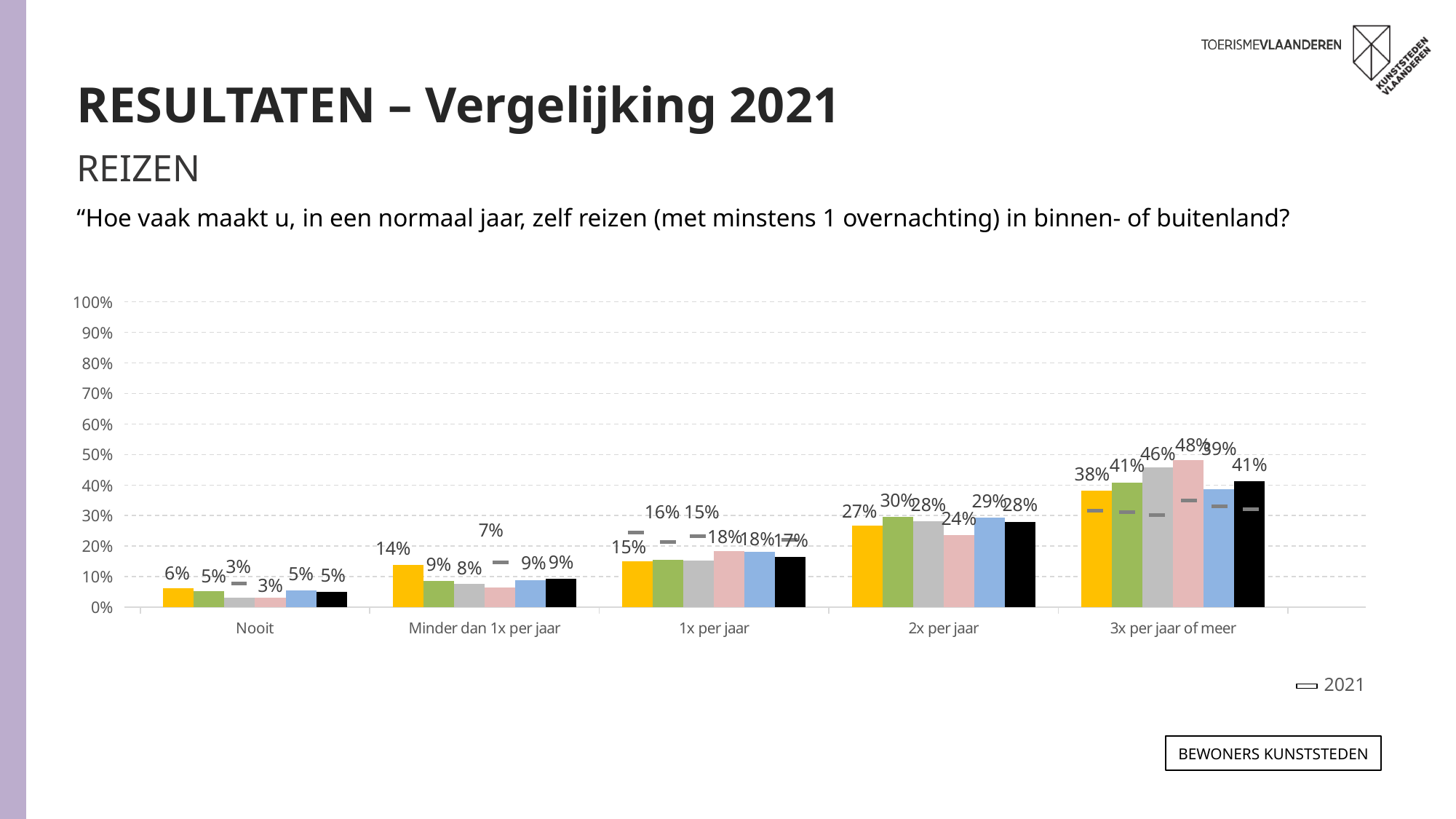
What kind of chart is shown on the slide? bar chart What is the value of the black bar for '2x per jaar'? 28% What entry does the chart legend list? 2021 What is the value of the pink bar for '3x per jaar of meer'? 48% Do the yellow bar values rise or fall from 'Nooit' to '3x per jaar of meer'? rise What is the value of the yellow bar for 'Minder dan 1x per jaar'? 14% For which category is the yellow bar highest? 3x per jaar of meer What is the difference between the pink bar and the yellow bar for '3x per jaar of meer'? 10% Which is larger for '2x per jaar': the green bar or the pink bar? the green bar For which category is the green bar lowest? Nooit How many categories are shown on the x axis of the chart? 5 Is the 2021 marker for the yellow bar in '2x per jaar' greater or less than 30%? less